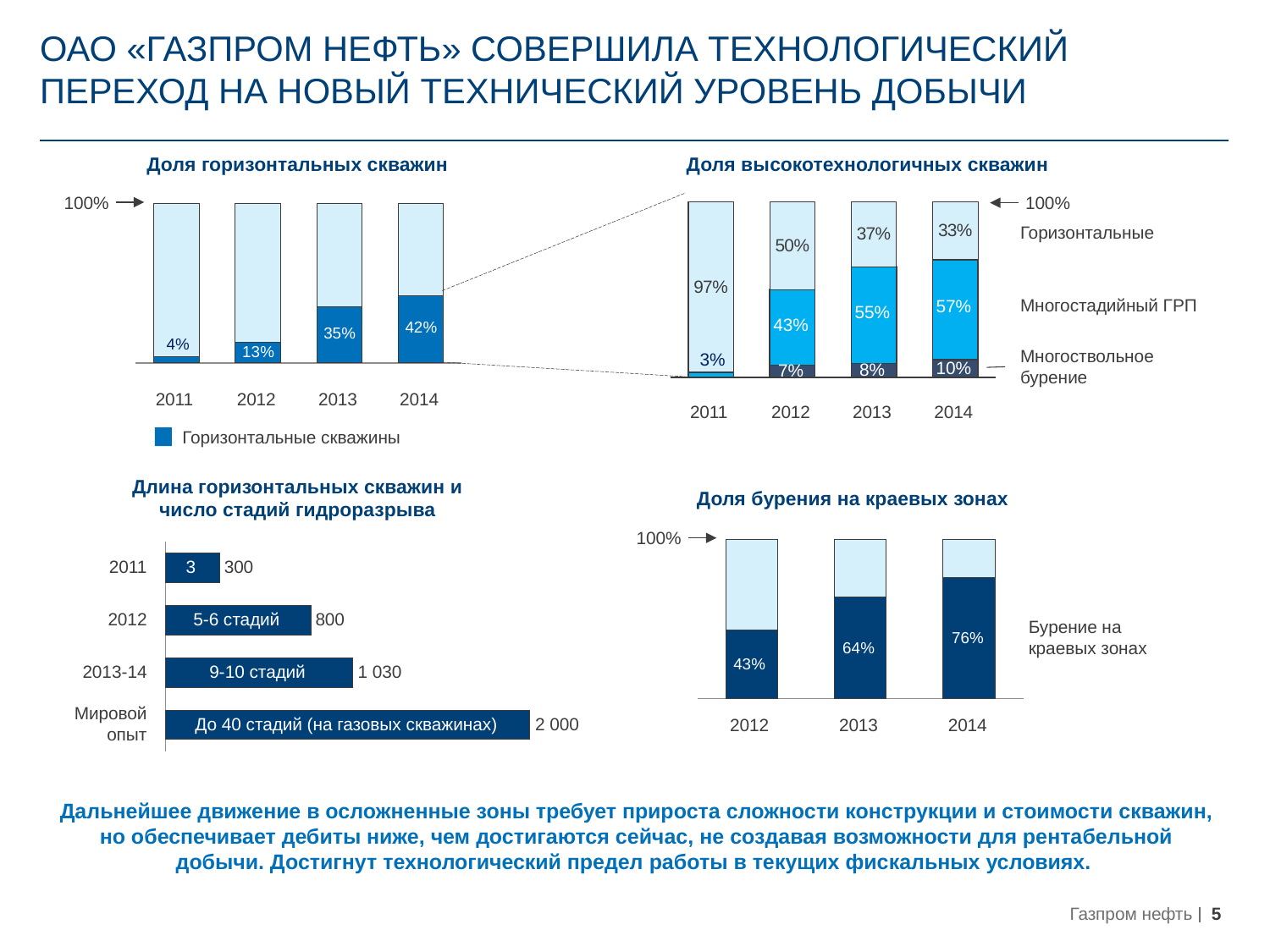
In the chart "Доля бурения на краевых зонах", what is the value for 2013? 64% In the chart "Доля горизонтальных скважин", what is the value for 2014? 42% In the chart "Доля горизонтальных скважин", which year has the lowest value? 2011 In the chart "Доля высокотехнологичных скважин", what is the share of "Многостадийный ГРП" in 2013? 55% In the chart "Доля высокотехнологичных скважин", how many series are shown in the legend? 3 In the chart "Доля высокотехнологичных скважин", what is the share of "Многоствольное бурение" in 2014? 10% In the chart "Доля высокотехнологичных скважин", which is larger in 2012: "Горизонтальные" or "Многостадийный ГРП"? Горизонтальные In the chart "Доля бурения на краевых зонах", how many years are shown on the x axis? 3 In the chart "Доля горизонтальных скважин", what is the difference between the 2014 and 2011 values? 38% In the chart "Доля горизонтальных скважин", do the values rise or fall from 2011 to 2014? rise In the chart "Длина горизонтальных скважин и число стадий гидроразрыва", what is the difference between "Мировой опыт" and 2012? 1 200 In the chart "Длина горизонтальных скважин и число стадий гидроразрыва", what is the value for 2013-14? 1 030